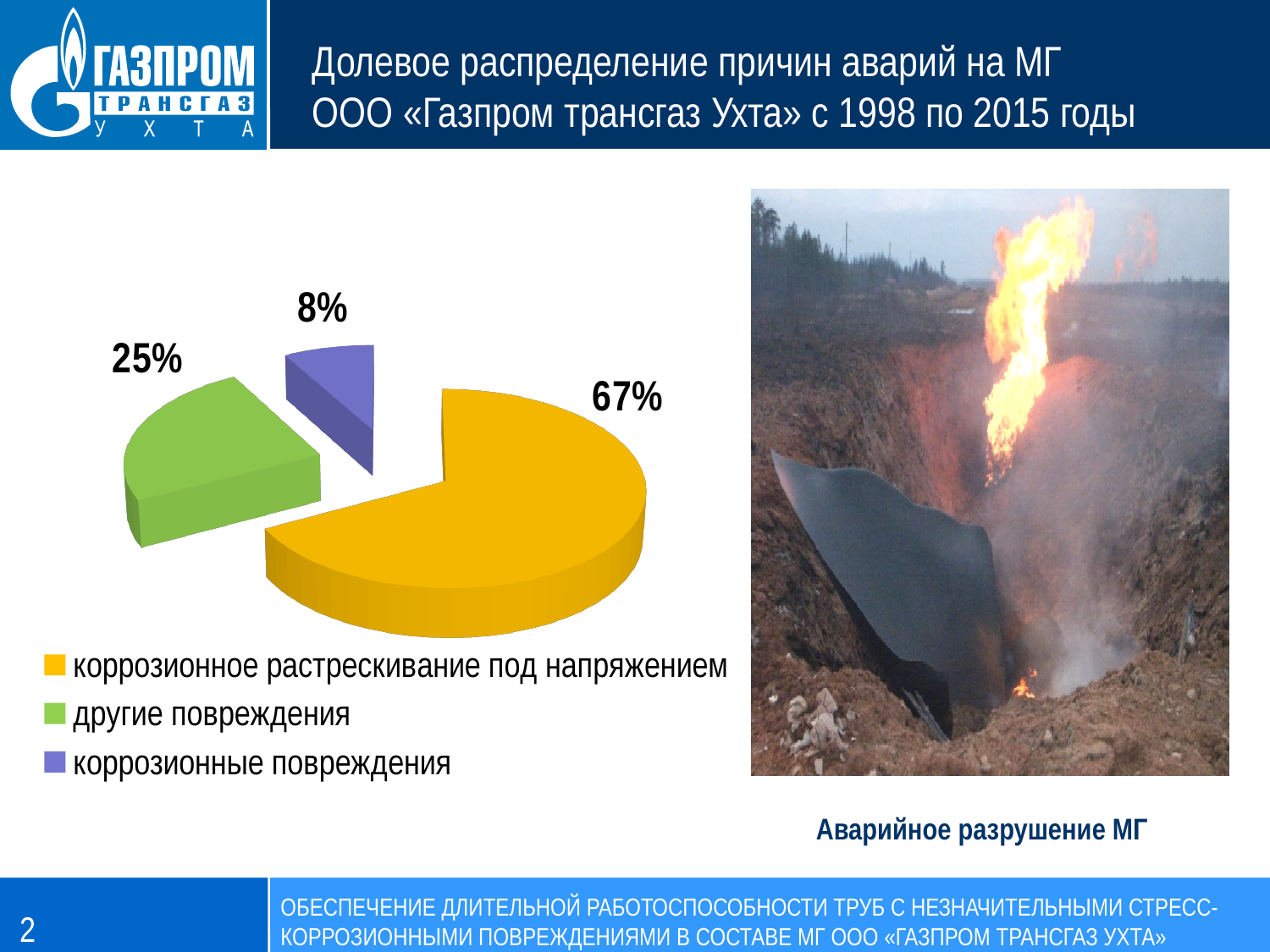
What is the difference in percentage points between the share for другие повреждения and the share for коррозионные повреждения? 17 What colour is the slice for другие повреждения? green What type of chart is shown on the slide? pie chart What share of accidents is attributed to другие повреждения? 25% Which cause of accidents has the largest share in the pie chart? коррозионное растрескивание под напряжением What share of accidents is attributed to коррозионное растрескивание под напряжением? 67% Which cause of accidents has the smallest share in the pie chart? коррозионные повреждения Which has a larger share: другие повреждения or коррозионные повреждения? другие повреждения How many entries does the legend of the pie chart list? 3 What is the difference in percentage points between the share for коррозионное растрескивание под напряжением and the share for другие повреждения? 42 How many slices does the pie chart have? 3 What share of accidents is attributed to коррозионные повреждения? 8%